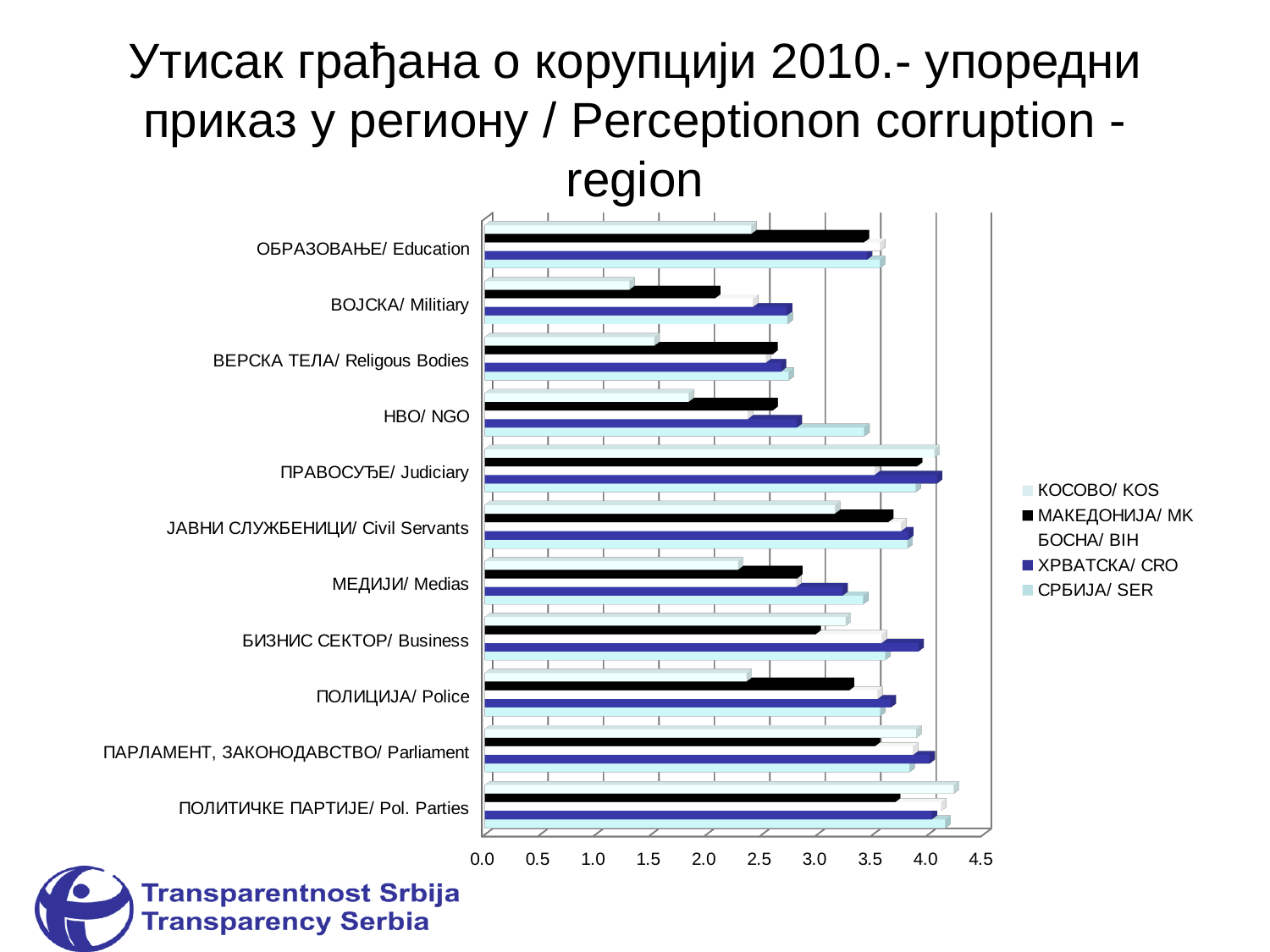
How many categories (institutions) are listed on the vertical axis of the chart? 11 In the ОБРАЗОВАЊЕ/ Education category, which is larger: the value for МАКЕДОНИЈА/ MK or the value for КОСОВО/ KOS? МАКЕДОНИЈА/ MK Is the value for КОСОВО/ KOS in the ВЕРСКА ТЕЛА/ Religous Bodies category greater or less than 2.0? less In the ВОЈСКА/ Militiary category, which is larger: the value for ХРВАТСКА/ CRO or the value for КОСОВО/ KOS? ХРВАТСКА/ CRO Is the value for ХРВАТСКА/ CRO in the ПОЛИТИЧКЕ ПАРТИЈЕ/ Pol. Parties category greater or less than 3.5? greater How many series does the chart legend list? 5 Is the value for МАКЕДОНИЈА/ MK in the ПРАВОСУЂЕ/ Judiciary category greater or less than 3.5? greater For the МАКЕДОНИЈА/ MK series, which category has the lowest value? ВОЈСКА/ Militiary What kind of chart is shown on the slide? Bar chart Which countries are listed in the chart legend? КОСОВО/ KOS, МАКЕДОНИЈА/ MK, БОСНА/ BIH, ХРВАТСКА/ CRO, СРБИЈА/ SER